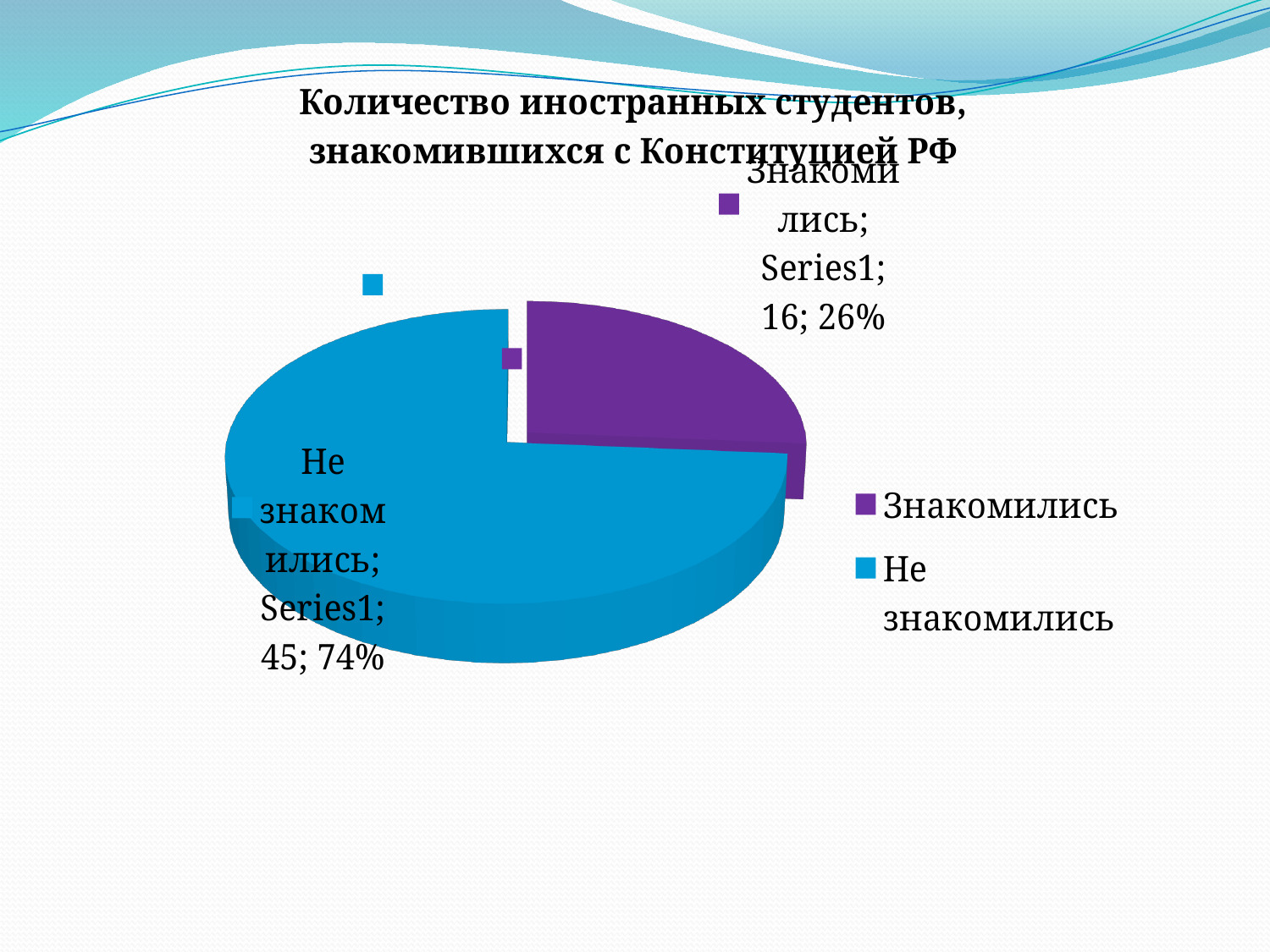
What kind of chart is shown on the slide? pie chart What is the difference between the values for Не знакомились and Знакомились? 29 How many categories does the pie chart have? 2 What is the title of the chart? Количество иностранных студентов, знакомившихся с Конституцией РФ What share of the pie does Знакомились represent? 26% What is the total of the two values shown in the pie chart? 61 What is the value for Не знакомились? 45 Which category has the largest slice? Не знакомились What is the value for Знакомились? 16 Which is larger, the value for Знакомились or the value for Не знакомились? Не знакомились Which category has the smallest slice? Знакомились What share of the pie does Не знакомились represent? 74%